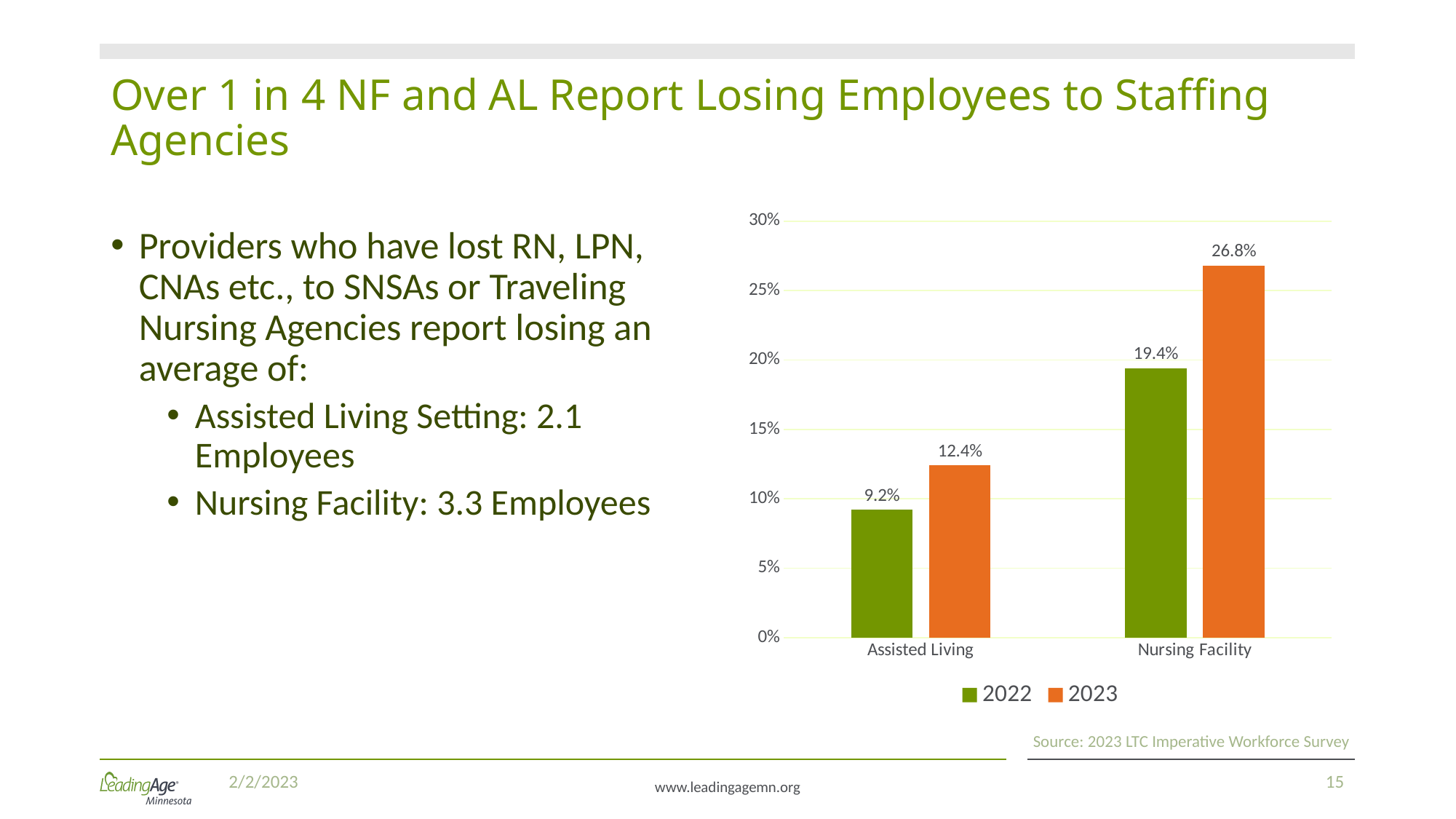
Which is larger: the 2022 value for Nursing Facility or the 2023 value for Assisted Living? 2022 value for Nursing Facility What is the difference between the 2023 and 2022 values for Nursing Facility? 7.4% What is the value for Assisted Living in 2022? 9.2% How many series does the legend list? 2 Which category has the lowest value in 2022? Assisted Living What is the difference between the 2023 and 2022 values for Assisted Living? 3.2% What is the value for Nursing Facility in 2023? 26.8% Which category has the highest value in 2023? Nursing Facility What is the value for Nursing Facility in 2022? 19.4% Which colour represents the 2023 series in the chart? Orange What is the value for Assisted Living in 2023? 12.4% What kind of chart is shown on the slide? Bar chart